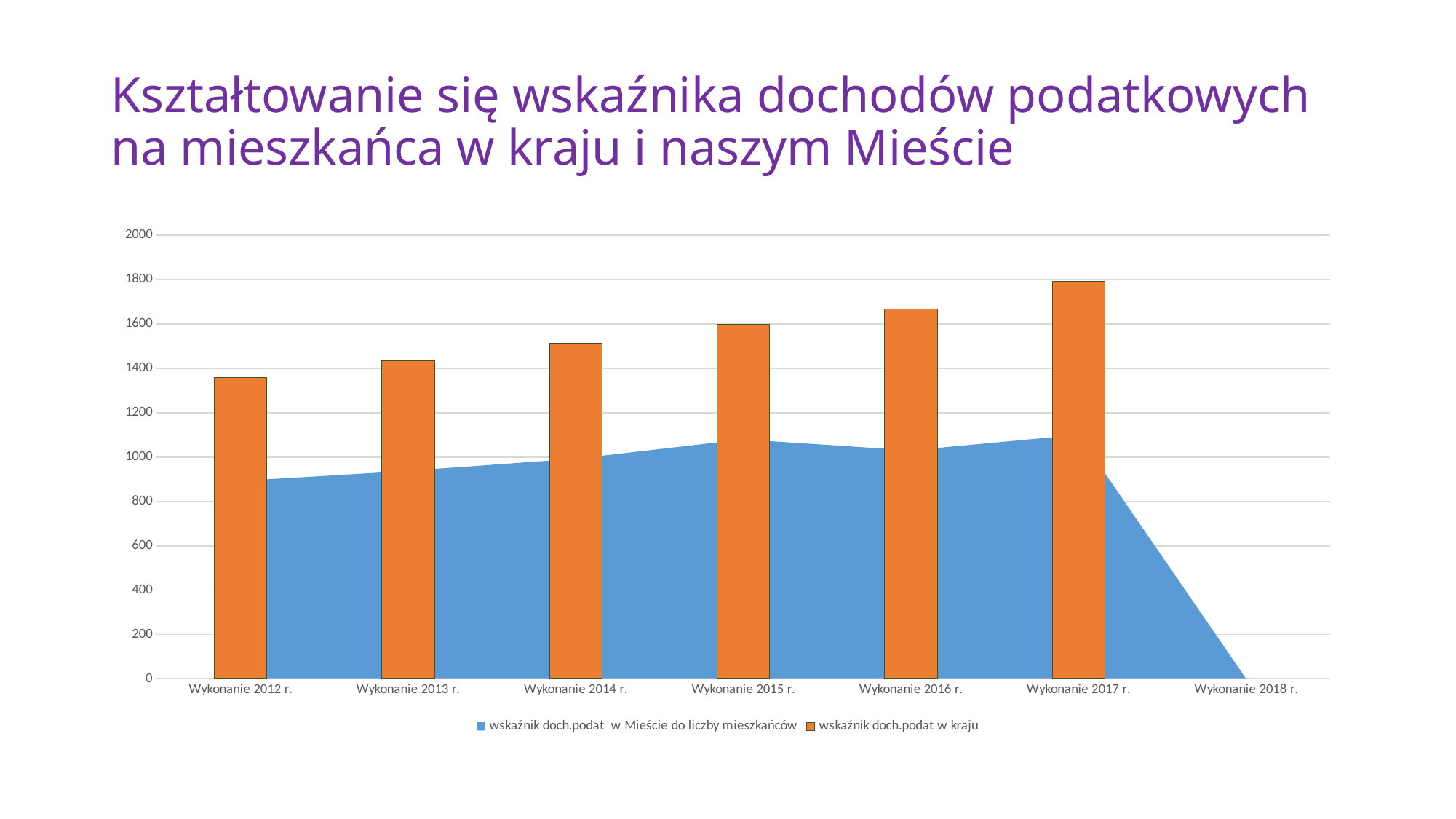
How many categories are shown on the x axis? 7 Is the value for 'wskaźnik doch.podat w Mieście do liczby mieszkańców' in Wykonanie 2017 r. greater or less than 1000? greater What kind of chart is this? A combination of a bar chart and an area chart Is the bar value for 'wskaźnik doch.podat w kraju' in Wykonanie 2012 r. greater or less than 1200? greater Which category has the lowest bar for 'wskaźnik doch.podat w kraju'? Wykonanie 2012 r. How many series does the legend list? 2 Which category has the highest bar for 'wskaźnik doch.podat w kraju'? Wykonanie 2017 r. What colour are the bars for 'wskaźnik doch.podat w kraju'? Orange Is the value for 'wskaźnik doch.podat w Mieście do liczby mieszkańców' in Wykonanie 2012 r. greater or less than 1000? less Do the bars for 'wskaźnik doch.podat w kraju' rise or fall from 2012 to 2017? rise In Wykonanie 2015 r., which series has the larger value: 'wskaźnik doch.podat w kraju' or 'wskaźnik doch.podat w Mieście do liczby mieszkańców'? wskaźnik doch.podat w kraju